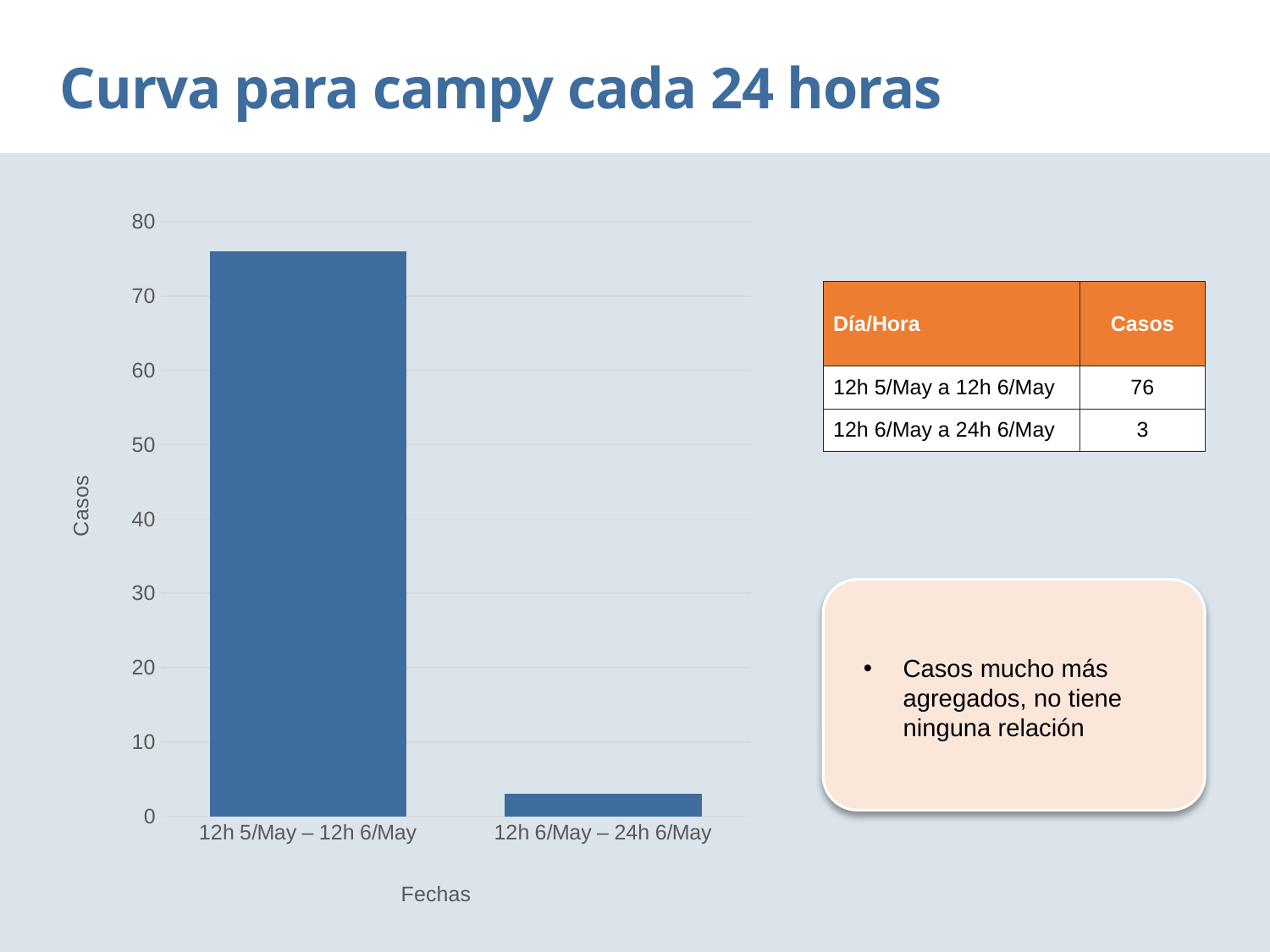
How many bars (categories) does the chart show? 2 What is the difference in cases between 12h 5/May a 12h 6/May and 12h 6/May a 24h 6/May? 73 Which is larger: the bar for 12h 5/May – 12h 6/May or the bar for 12h 6/May – 24h 6/May? 12h 5/May – 12h 6/May What kind of chart is shown on the slide? bar chart Do the values rise or fall from left to right along the x axis? fall According to the slide, how many cases are there for 12h 5/May a 12h 6/May? 76 Is the value for 12h 6/May – 24h 6/May greater or less than 10? less According to the slide, how many cases are there for 12h 6/May a 24h 6/May? 3 What is the label of the vertical axis of the chart? Casos Is the value for 12h 5/May – 12h 6/May greater or less than 70? greater Which period has the lowest number of cases in the chart? 12h 6/May – 24h 6/May Which period has the highest number of cases in the chart? 12h 5/May – 12h 6/May